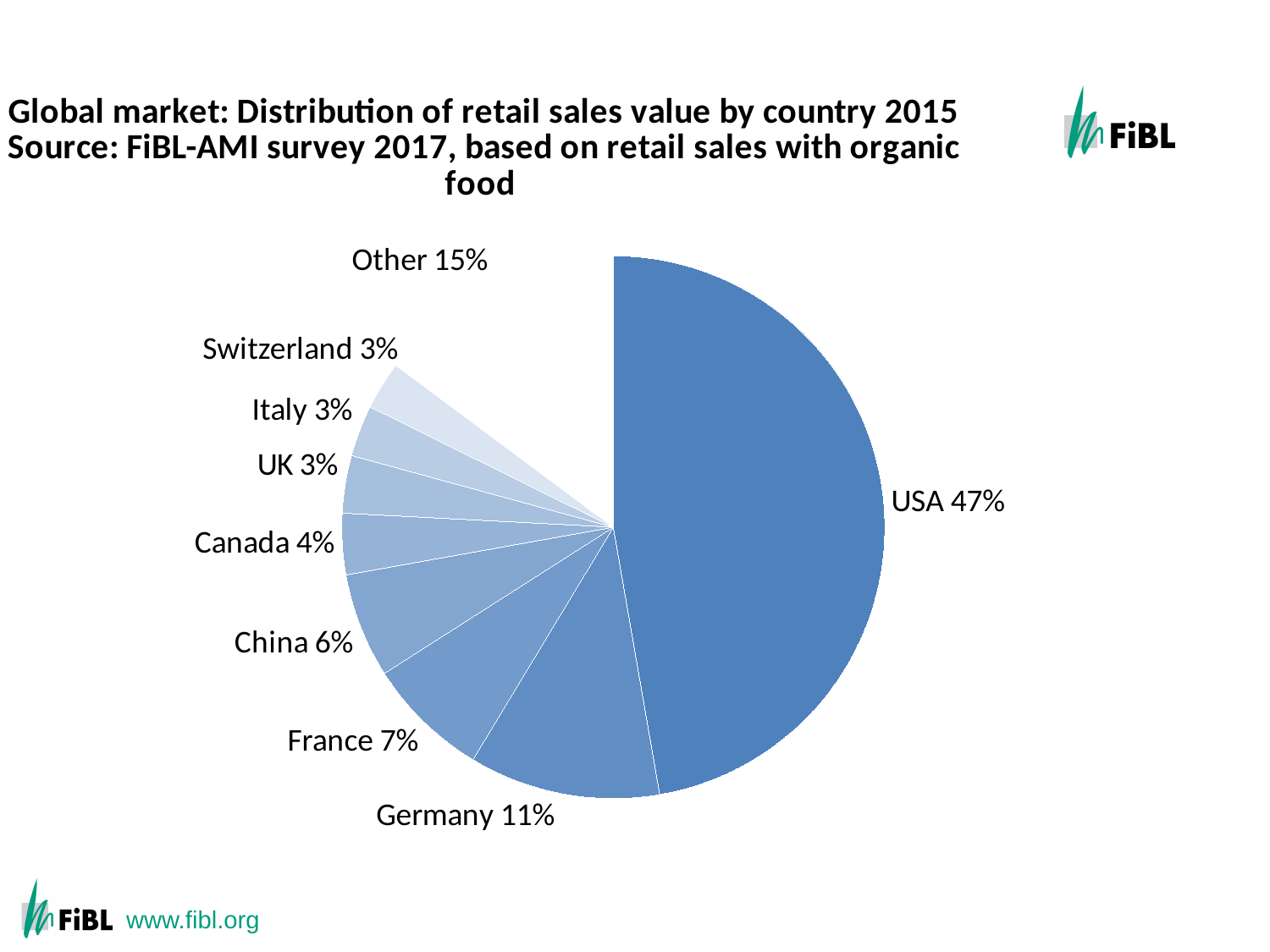
What share of retail sales value does the USA hold? 47% Which has a larger share, France or China? France How many slices does the pie chart have? 9 What share of retail sales value does China hold? 6% What is the combined share of Germany and France? 18% Which country has the largest share of retail sales value? USA What share of retail sales value does Germany hold? 11% What kind of chart is shown on the slide? pie chart What is the difference in percentage points between the USA's share and Germany's share? 36 What share of retail sales value is labelled Other? 15% What share of retail sales value does Canada hold? 4% What share of retail sales value does France hold? 7%